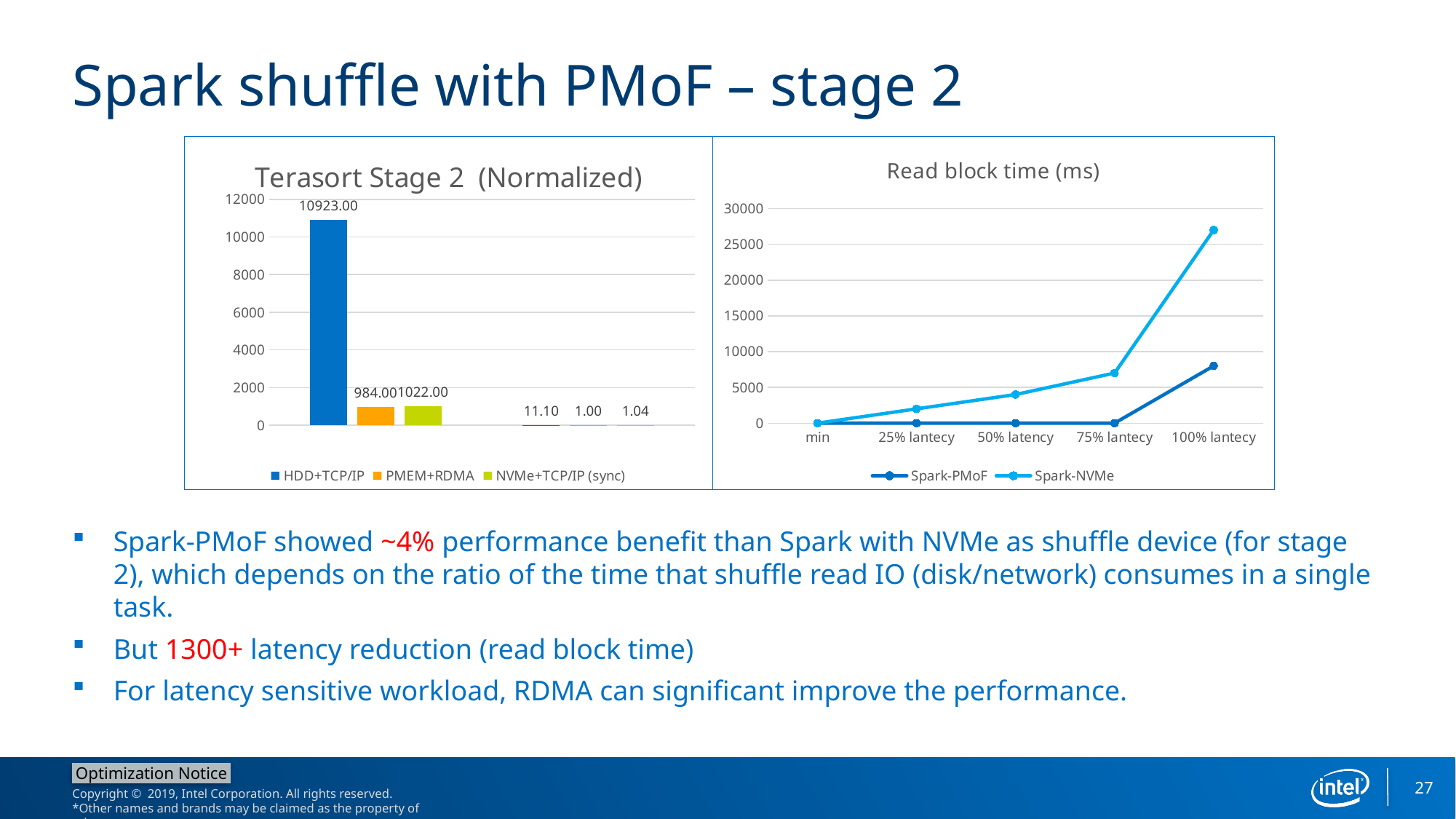
What kind of chart is the 'Terasort Stage 2 (Normalized)' chart on the left? bar chart In the 'Terasort Stage 2 (Normalized)' chart, which series has the tallest bar? HDD+TCP/IP In the 'Read block time (ms)' chart, which series is higher at '75% lantecy', Spark-PMoF or Spark-NVMe? Spark-NVMe In the 'Read block time (ms)' chart, how many series does the legend list? 2 In the 'Terasort Stage 2 (Normalized)' chart, how many series does the legend list? 3 In the 'Terasort Stage 2 (Normalized)' chart, what is the difference between the HDD+TCP/IP bar labelled 10923.00 and the PMEM+RDMA bar labelled 984.00? 9939.00 What kind of chart is the 'Read block time (ms)' chart on the right? line chart In the 'Read block time (ms)' chart, how many points are on the x axis? 5 In the 'Read block time (ms)' chart, does the Spark-NVMe line rise or fall from 'min' to '100% lantecy'? rise In the 'Read block time (ms)' chart, is the Spark-NVMe value at '100% lantecy' greater or less than 25000? greater In the 'Terasort Stage 2 (Normalized)' chart, what is the largest value labelled on any bar? 10923.00 In the 'Read block time (ms)' chart, is the Spark-PMoF value at '100% lantecy' greater or less than 10000? less